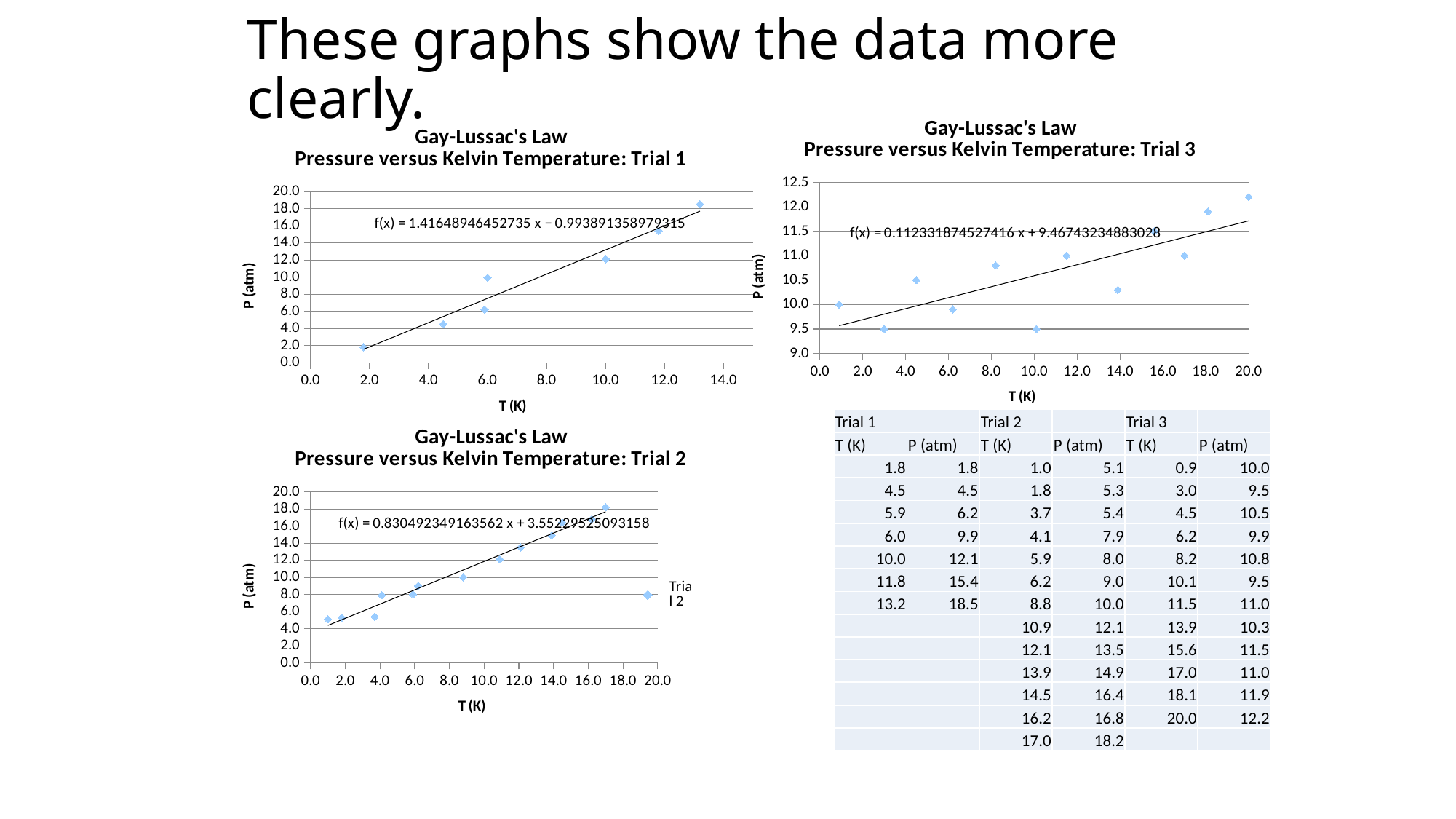
On the 'Pressure versus Kelvin Temperature: Trial 1' chart, do the pressure values generally rise or fall as temperature increases? rise On the 'Pressure versus Kelvin Temperature: Trial 1' chart, is the pressure at T = 10.0 K greater or less than 10.0 atm? greater On the 'Pressure versus Kelvin Temperature: Trial 3' chart, is the pressure at T = 3.0 K greater or less than 10.0 atm? less What kind of chart is the 'Pressure versus Kelvin Temperature: Trial 1' chart? scatter chart According to the table, what is the pressure for Trial 3 at T = 20.0 K? 12.2 How many data points are plotted on the 'Pressure versus Kelvin Temperature: Trial 3' chart? 12 What is the y-axis label on the 'Pressure versus Kelvin Temperature: Trial 3' chart? P (atm) How many data points are plotted on the 'Pressure versus Kelvin Temperature: Trial 2' chart? 13 On the 'Pressure versus Kelvin Temperature: Trial 2' chart, is the pressure at T = 17.0 K greater or less than 16.0 atm? greater How many series does the legend on the 'Pressure versus Kelvin Temperature: Trial 2' chart list? 1 How many data points are plotted on the 'Pressure versus Kelvin Temperature: Trial 1' chart? 7 According to the table, what is the pressure for Trial 1 at T = 13.2 K? 18.5